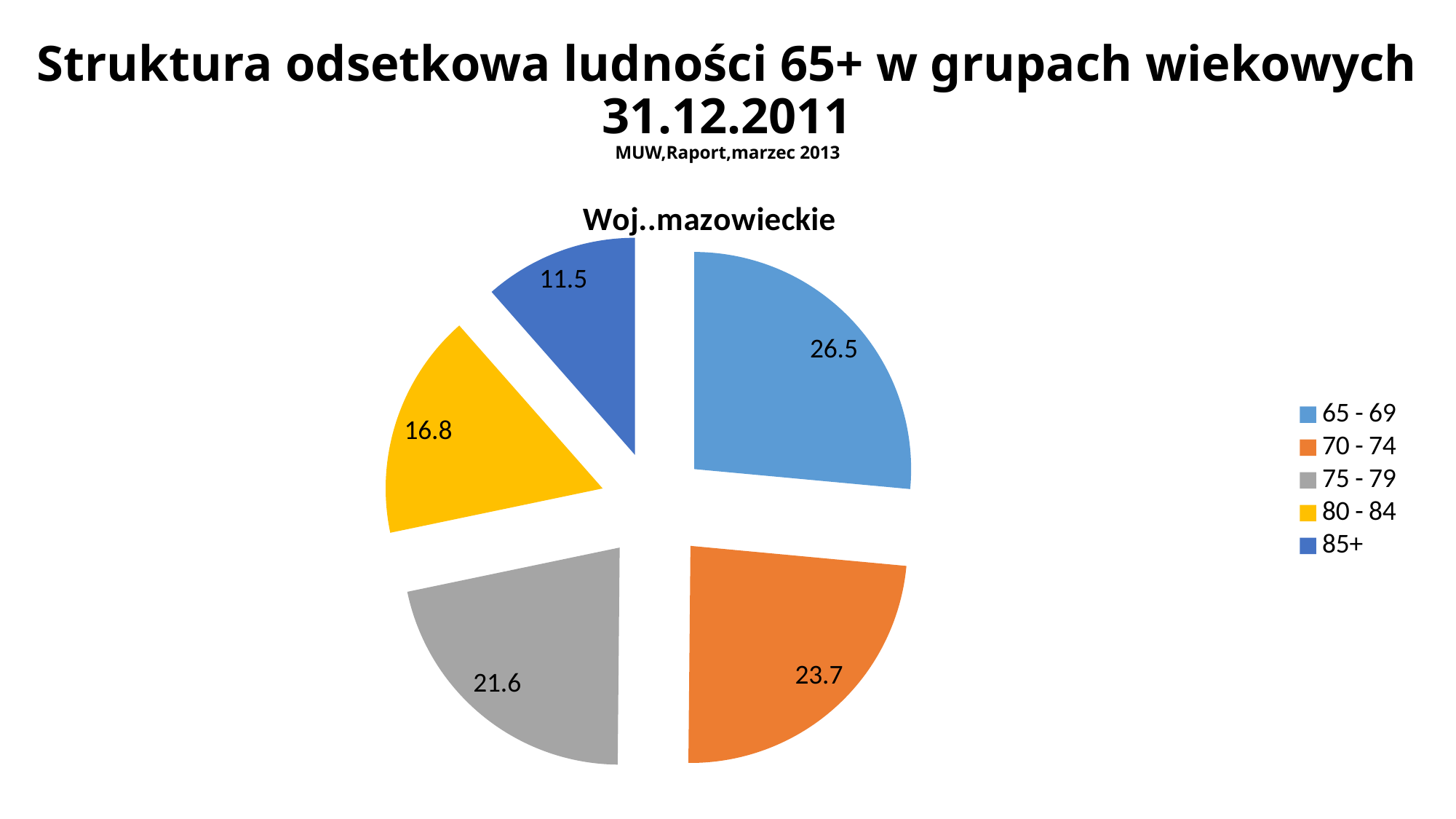
What is the title shown directly above the pie chart? Woj..mazowieckie What is the difference between the values for 70 - 74 and 80 - 84? 6.9 Which age group has the largest slice? 65 - 69 What is the value for the 75 - 79 age group? 21.6 What colour is the slice for the 80 - 84 age group? yellow What is the value for the 65 - 69 age group? 26.5 Which age group has the smallest slice? 85+ What kind of chart is shown on the slide? pie chart How many slices does the pie chart have? 5 What is the value for the 85+ age group? 11.5 Which is larger, the value for 70 - 74 or the value for 75 - 79? 70 - 74 How many entries does the legend list? 5